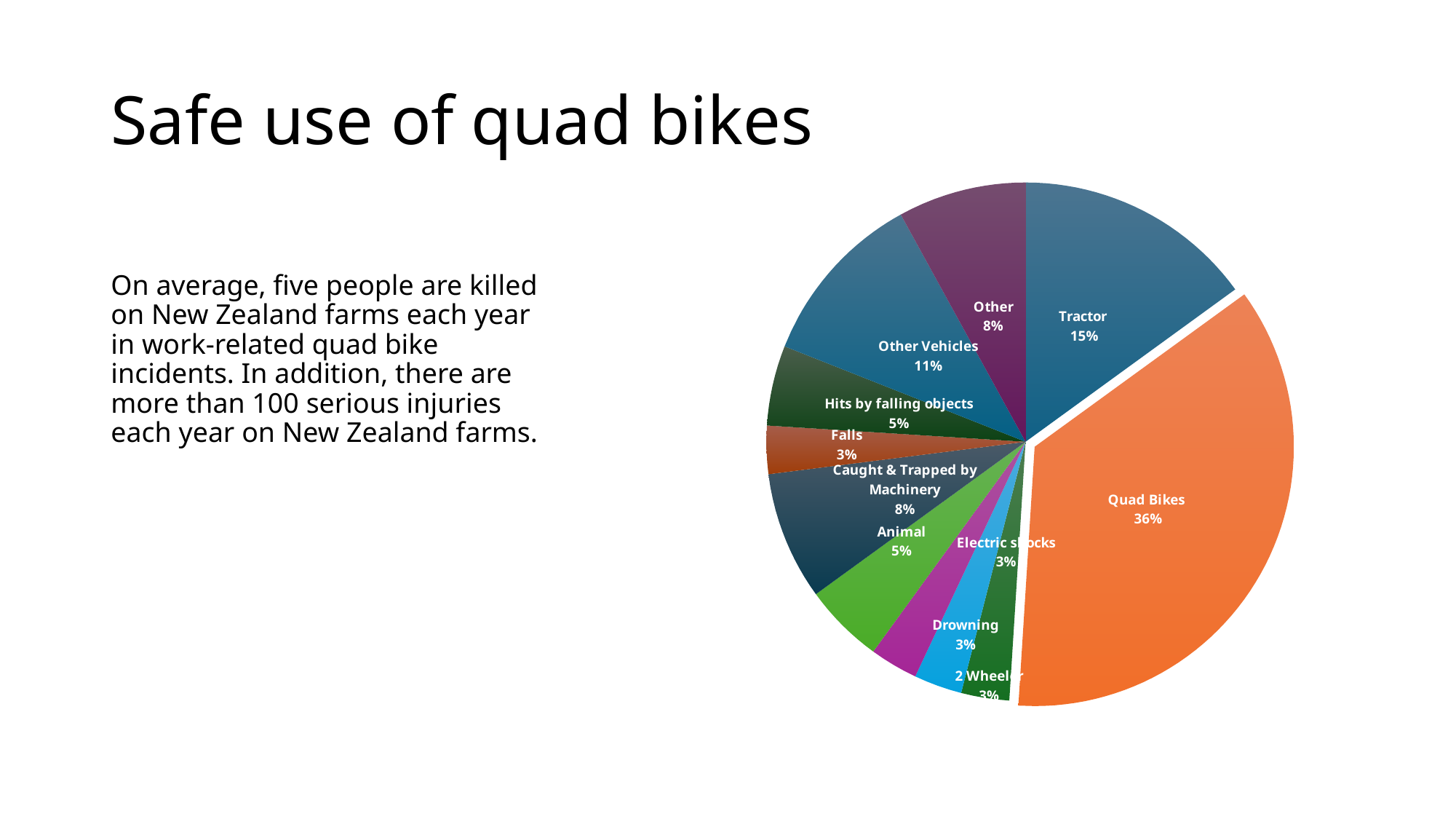
What is the value shown for Hits by falling objects? 5% What is the value shown for Caught & Trapped by Machinery? 8% Which category has the largest slice of the pie? Quad Bikes Which slice of the pie is pulled out (exploded) from the rest? Quad Bikes What is the value shown for Tractor? 15% Which is larger, the share for Other Vehicles or the share for Other? Other Vehicles What is the value shown for Other Vehicles? 11% What share of the pie does Quad Bikes account for? 36% What kind of chart is shown on the slide? pie chart What is the combined share of Tractor and Other Vehicles? 26% What is the difference between the Quad Bikes share and the Tractor share? 21% How many slices does the pie chart have? 11